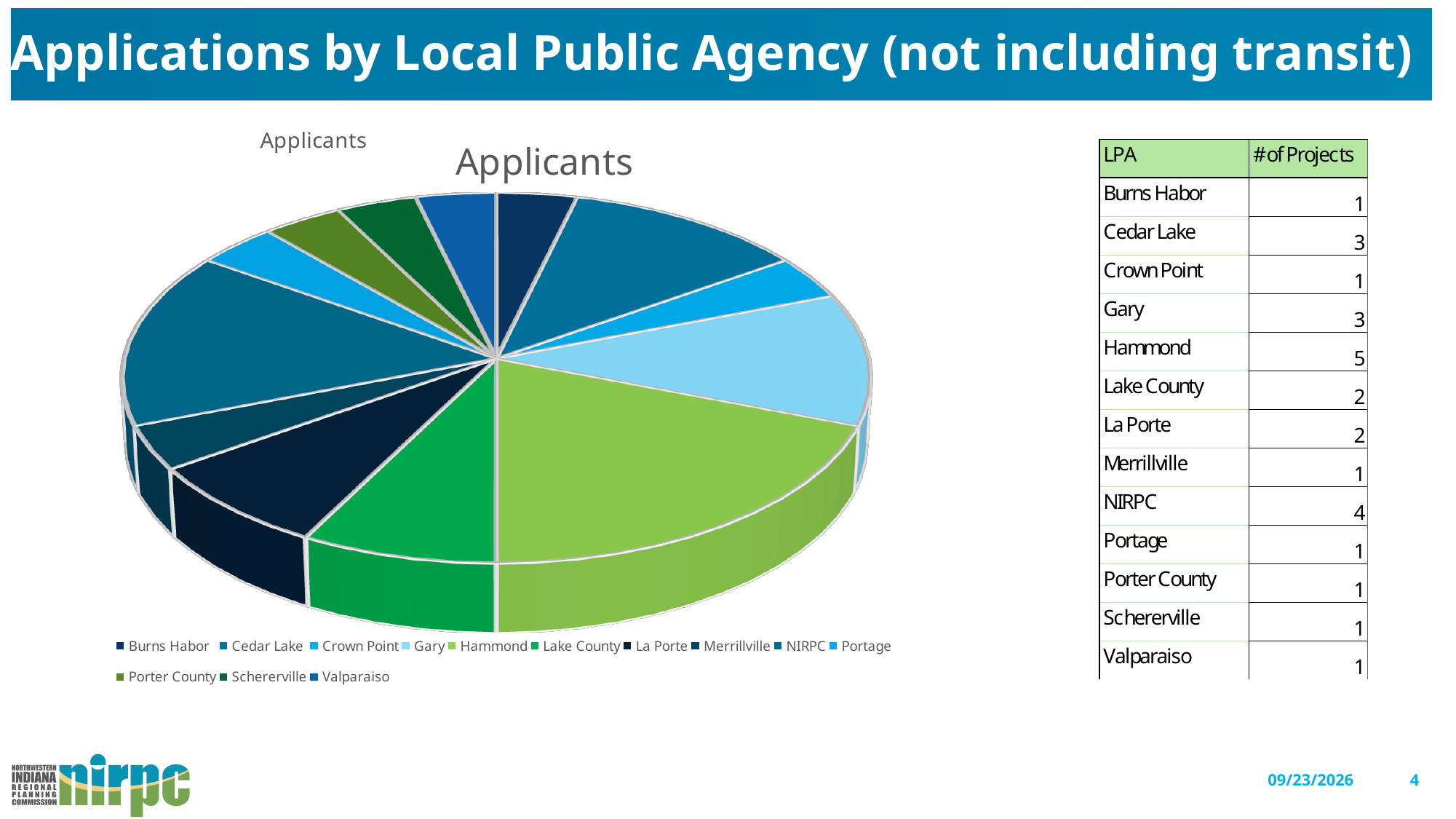
Which has more projects, NIRPC or Cedar Lake? NIRPC How many categories (slices) does the Applicants pie chart have? 13 What is the total number of projects across all applicants shown in the table? 26 How many projects does Lake County have according to the slide? 2 How many projects does Gary have according to the slide? 3 How many projects does Hammond have according to the slide? 5 Which has more projects, Hammond or Gary? Hammond How many projects does NIRPC have according to the slide? 4 What is the difference in number of projects between Hammond and NIRPC? 1 Which applicant has the largest slice of the Applicants pie chart? Hammond What is the title of the pie chart? Applicants What kind of chart is shown on the slide? pie chart